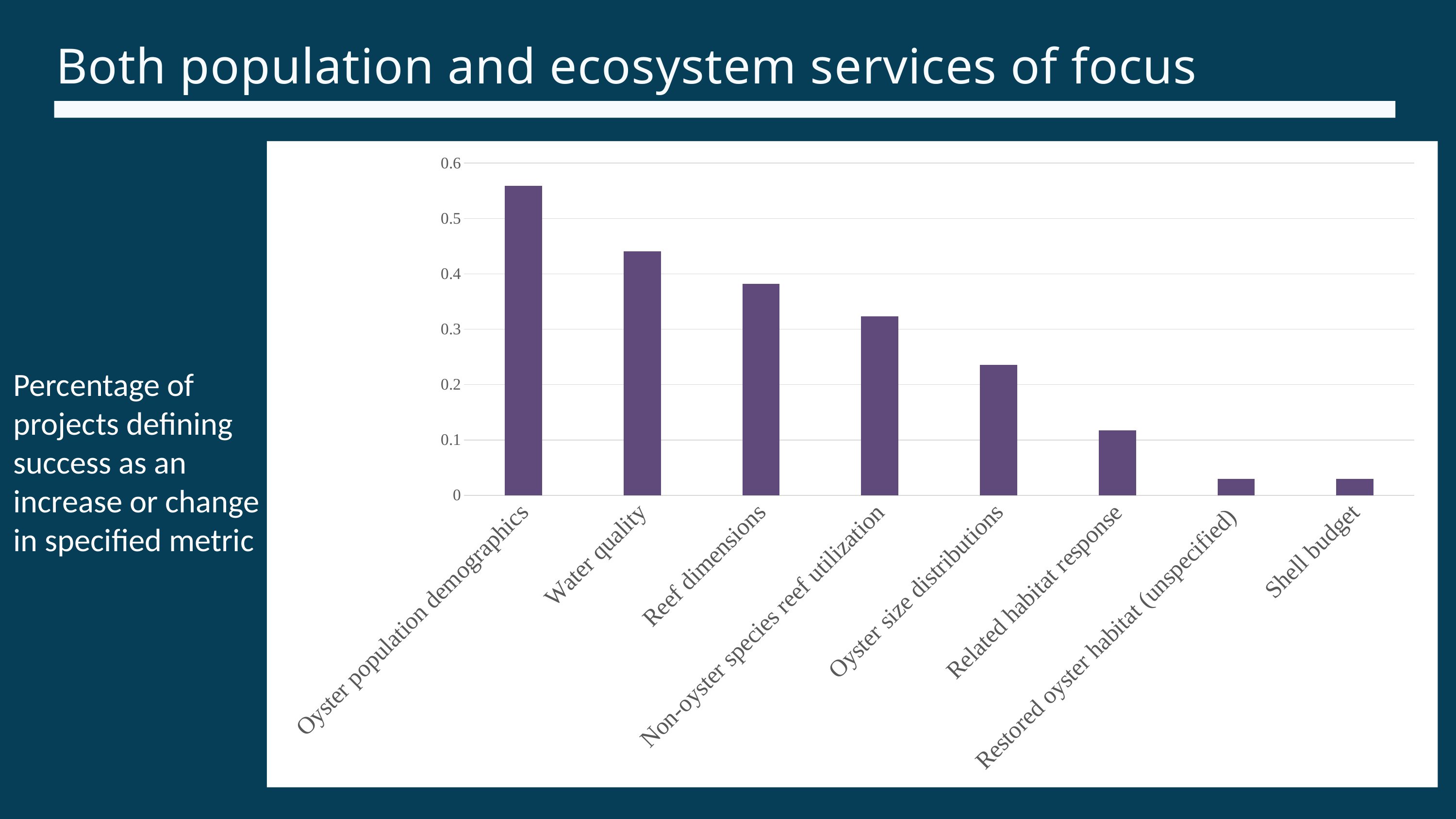
Which is larger, the value for Water quality or the value for Non-oyster species reef utilization? Water quality What is the title of the slide containing the chart? Both population and ecosystem services of focus What kind of chart is shown on the slide? bar chart Which category has the highest bar in the chart? Oyster population demographics Is the value for Water quality greater or less than 0.5? less How many categories are plotted on the x axis of the chart? 8 Is the value for Reef dimensions greater or less than 0.3? greater Is the value for Related habitat response greater or less than 0.1? greater Do the bar values rise or fall moving from left to right along the x axis? fall